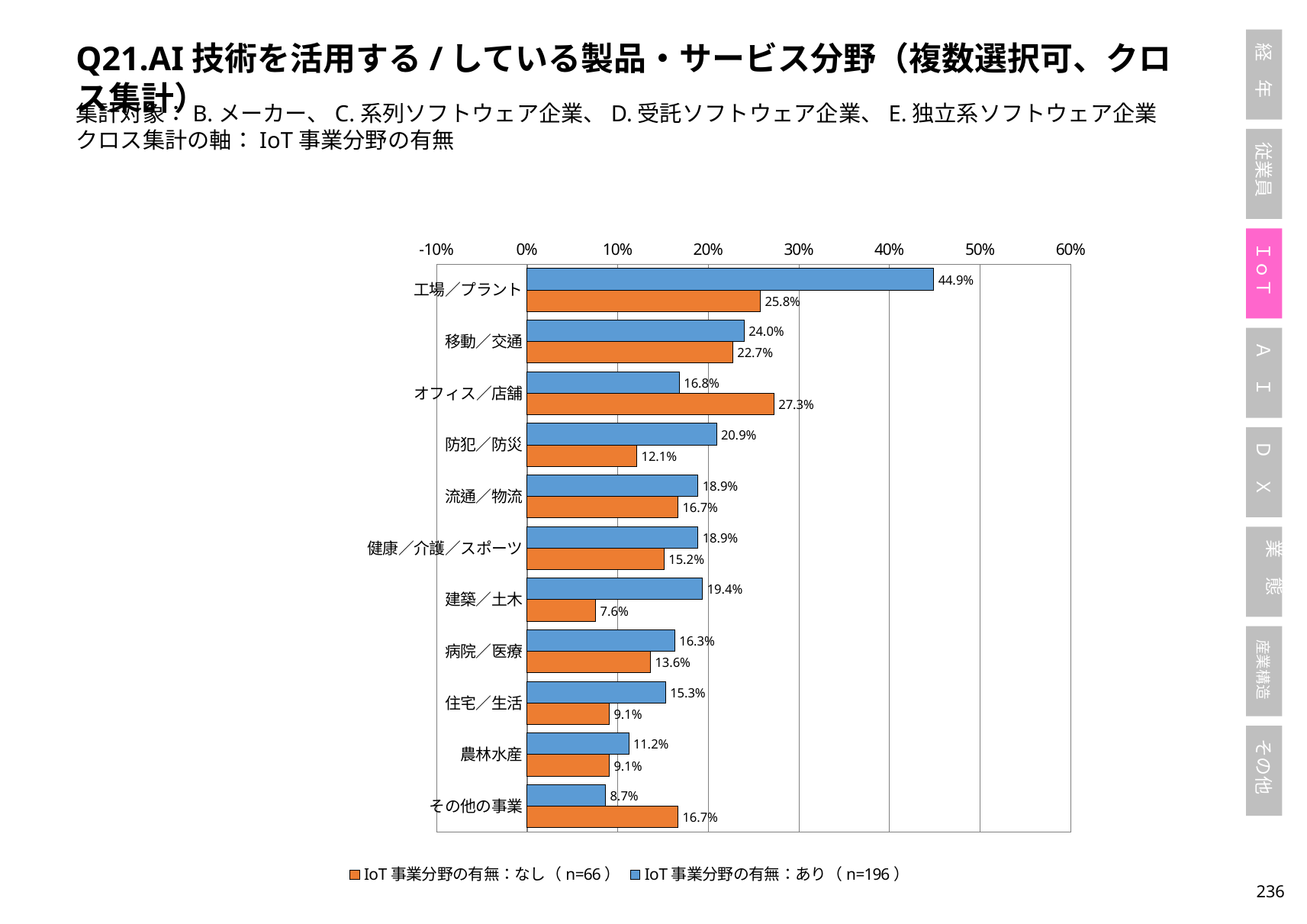
What is the value for オフィス／店舗 in the IoT事業分野の有無：なし（n=66） series? 27.3% Is the value for 防犯／防災 in the IoT事業分野の有無：あり（n=196） series greater or less than 20%? greater Which category has the highest value in the IoT事業分野の有無：あり（n=196） series? 工場／プラント What is the value for 建築／土木 in the IoT事業分野の有無：なし（n=66） series? 7.6% Which category has the lowest value in the IoT事業分野の有無：あり（n=196） series? その他の事業 How many series does the legend list? 2 For オフィス／店舗, which series has the larger value: IoT事業分野の有無：あり（n=196） or IoT事業分野の有無：なし（n=66）? IoT事業分野の有無：なし（n=66） Which category has the lowest value in the IoT事業分野の有無：なし（n=66） series? 建築／土木 What is the value for 工場／プラント in the IoT事業分野の有無：あり（n=196） series? 44.9% What is the difference between the IoT事業分野の有無：あり（n=196） and IoT事業分野の有無：なし（n=66） values for 工場／プラント? 19.1% What kind of chart is shown on the slide? Bar chart How many categories are shown on the chart? 11